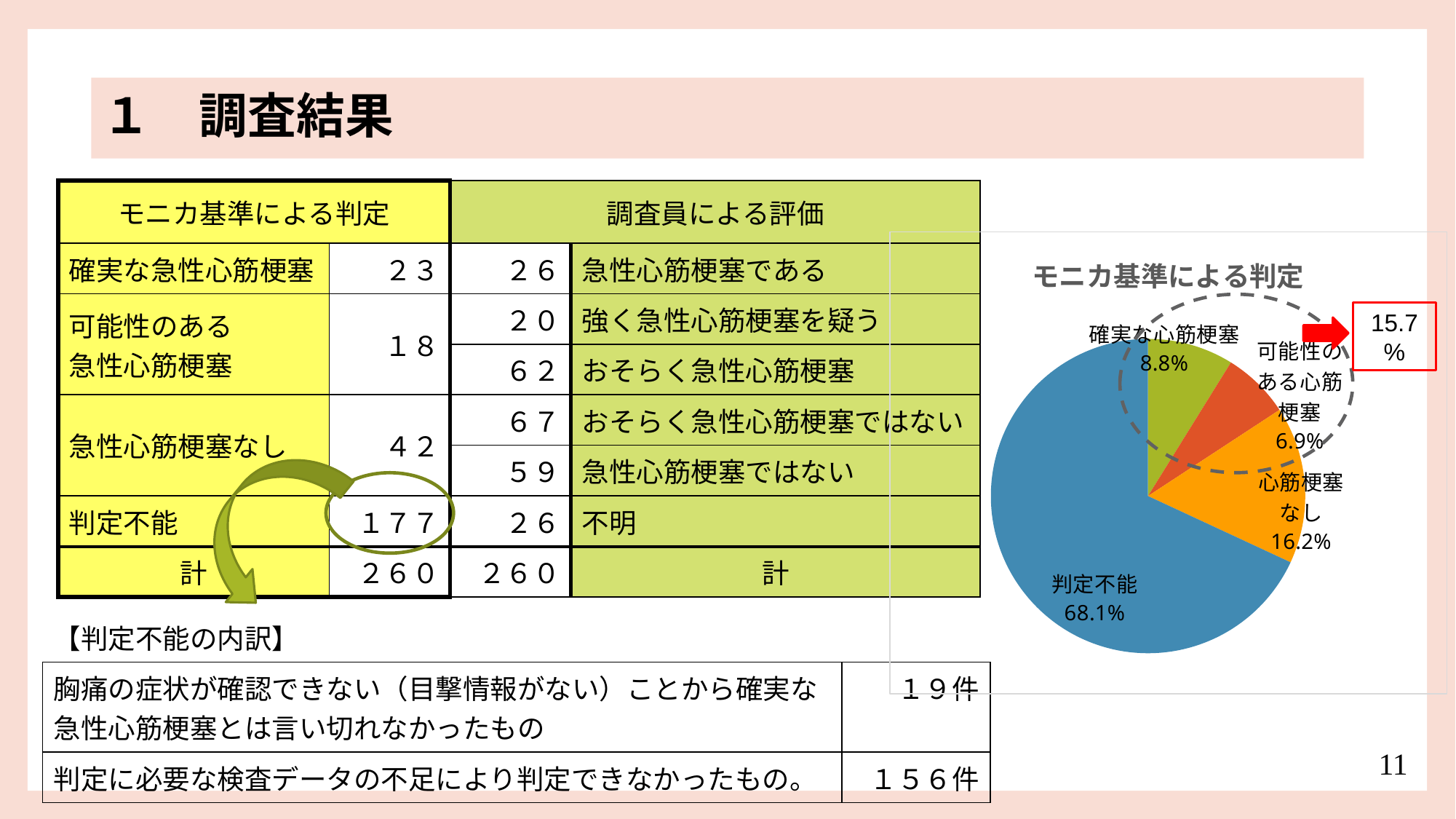
How many slices does the pie chart have? 4 What combined percentage is shown in the red box next to the dashed circle on the pie chart? 15.7% What percentage does the 心筋梗塞なし slice represent in the pie chart? 16.2% Which slice of the pie chart is the largest? 判定不能 What percentage does the 判定不能 slice represent in the pie chart? 68.1% Which is larger in the pie chart, 心筋梗塞なし or 確実な心筋梗塞? 心筋梗塞なし What is the difference between the 判定不能 slice and the 心筋梗塞なし slice in the pie chart? 51.9% What type of chart is shown on the slide? pie chart What percentage does the 可能性のある心筋梗塞 slice represent in the pie chart? 6.9% What is the title of the pie chart? モニカ基準による判定 Which slice of the pie chart is the smallest? 可能性のある心筋梗塞 What percentage does the 確実な心筋梗塞 slice represent in the pie chart? 8.8%